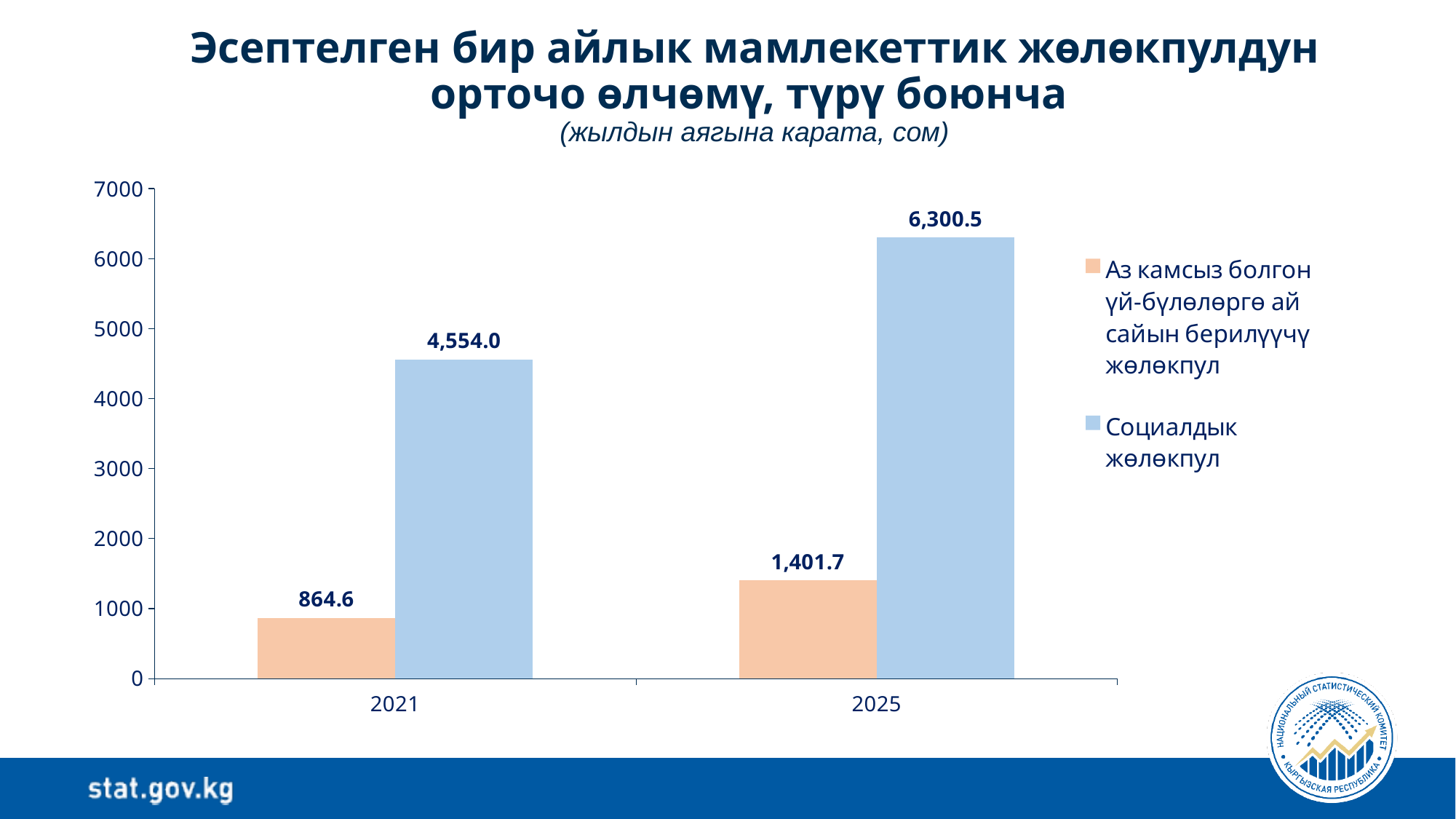
Does the value of Аз камсыз болгон үй-бүлөлөргө ай сайын берилүүчү жөлөкпул rise or fall from 2021 to 2025? rise What is the value of Аз камсыз болгон үй-бүлөлөргө ай сайын берилүүчү жөлөкпул in 2021? 864.6 How many series does the legend list? 2 Which year has the higher value for Социалдык жөлөкпул? 2025 What is the value of Аз камсыз болгон үй-бүлөлөргө ай сайын берилүүчү жөлөкпул in 2025? 1,401.7 What type of chart is shown on the slide? bar chart By how much did Социалдык жөлөкпул increase from 2021 to 2025? 1,746.5 What is the value of Социалдык жөлөкпул in 2021? 4,554.0 Is the value for Аз камсыз болгон үй-бүлөлөргө ай сайын берилүүчү жөлөкпул in 2025 greater or less than 1000? greater Which bar on the chart has the lowest value? Аз камсыз болгон үй-бүлөлөргө ай сайын берилүүчү жөлөкпул in 2021 What is the difference between Социалдык жөлөкпул and Аз камсыз болгон үй-бүлөлөргө ай сайын берилүүчү жөлөкпул in 2025? 4,898.8 What is the value of Социалдык жөлөкпул in 2025? 6,300.5